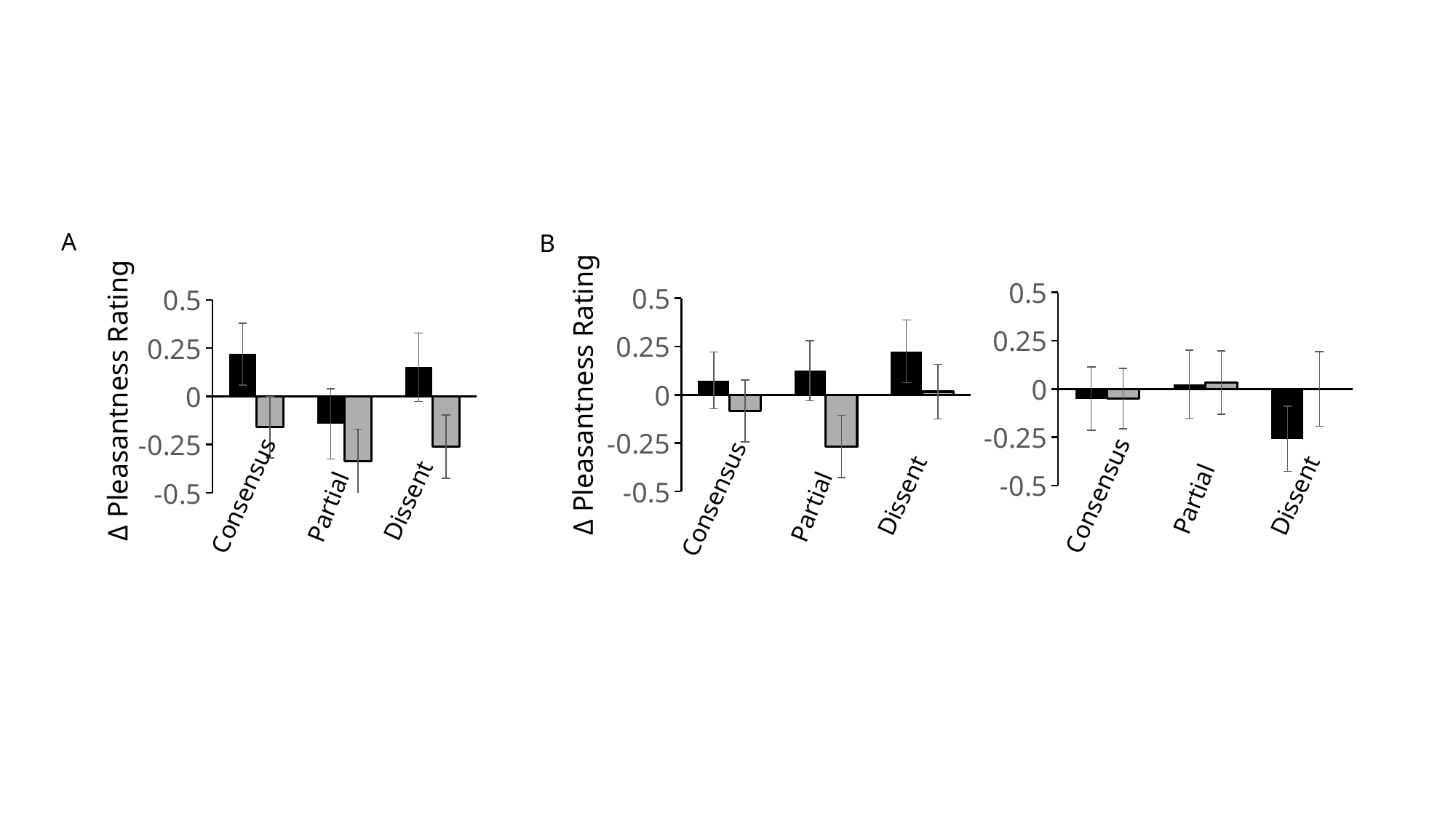
In panel A, is the value of the grey bar for Partial greater or less than -0.25? less In panel A, which is larger: the black bar for Consensus or the black bar for Dissent? Consensus What is the y-axis label of panel A? Δ Pleasantness Rating What kind of chart is panel A? bar chart In the left chart of panel B, is the value of the grey bar for Partial greater or less than 0? less In the right chart of panel B, which category has the lowest black bar? Dissent In panel A, is the value of the black bar for Consensus greater or less than 0? greater In panel A, which category has the lowest grey bar? Partial In the left chart of panel B, which category has the highest black bar? Dissent How many bar charts are on the slide in total? 3 How many categories are shown on the x axis of panel A? 3